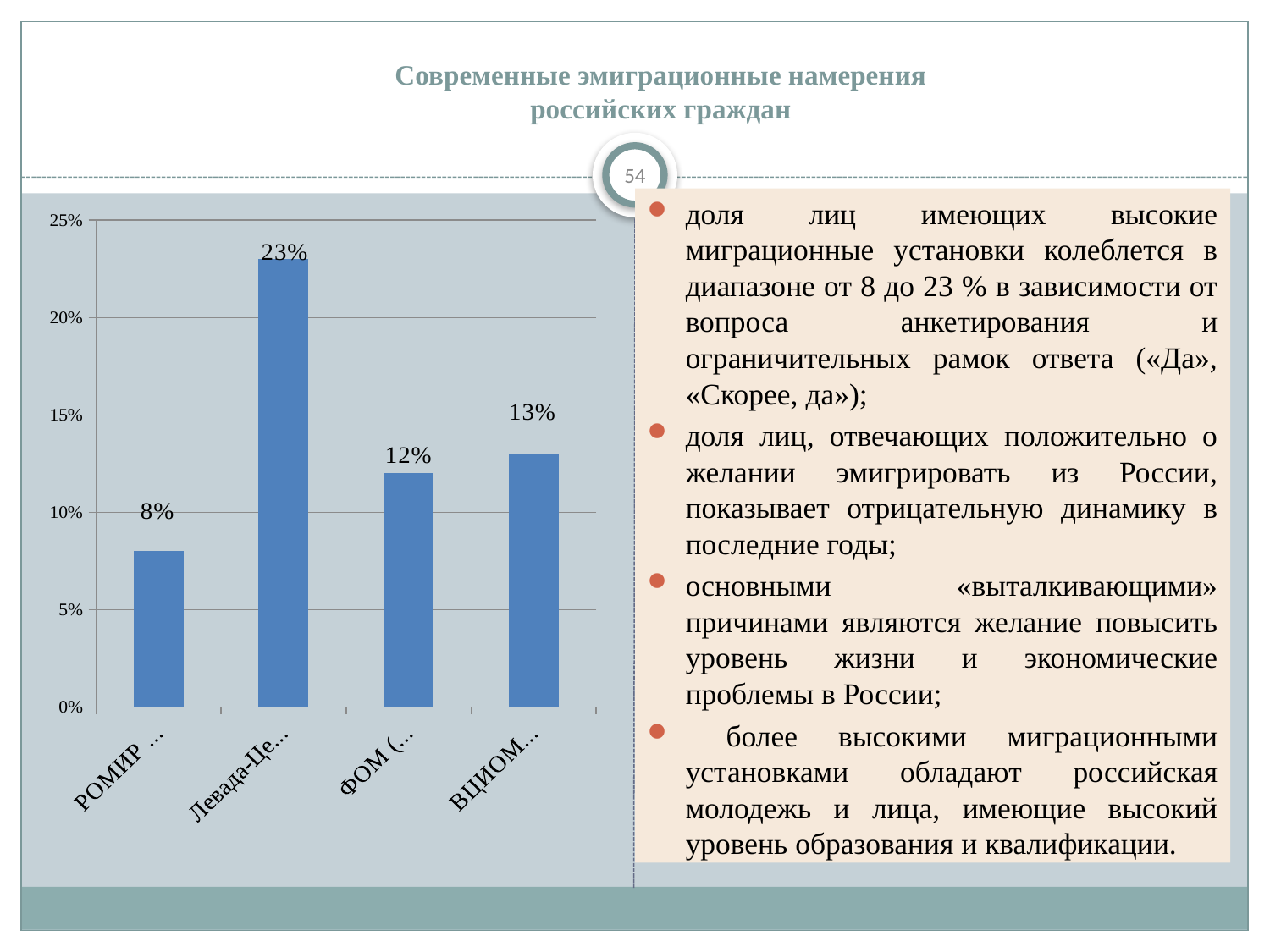
How many bars are shown in the chart? 4 What is the value for ВЦИОМ? 13% What is the title of the slide containing the chart? Современные эмиграционные намерения российских граждан What is the value for ФОМ? 12% Which category has the highest value? Левада-Центр Which category has the lowest value? РОМИР What is the value for Левада-Центр? 23% Is the value for Левада-Центр greater or less than 20%? greater Which is larger, the value for ВЦИОМ or the value for ФОМ? ВЦИОМ What kind of chart is shown on the slide? bar chart What is the value for РОМИР? 8% What is the difference between the values for Левада-Центр and РОМИР? 15%